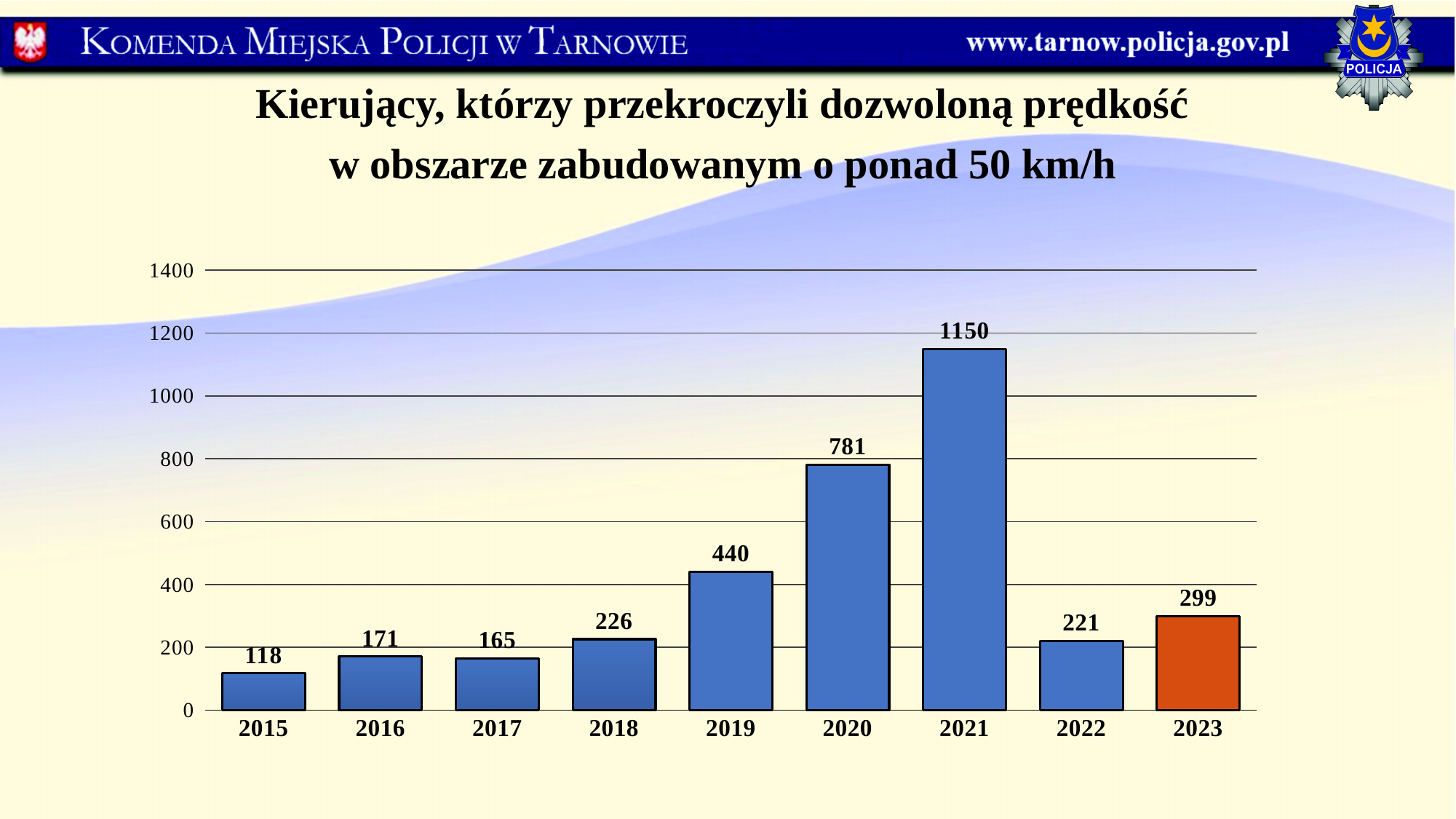
What kind of chart is shown on the slide? bar chart Which year has the highest value? 2021 Which is larger, the value for 2016 or the value for 2017? 2016 Is the value for 2019 greater or less than 400? greater What is the value for 2023? 299 How many years are shown on the x axis? 9 Which year has the lowest value? 2015 Which bar is shown in a different colour (orange) from the others? 2023 What is the value for 2021? 1150 What is the value for 2015? 118 What is the difference between the values for 2023 and 2022? 78 What is the difference between the values for 2021 and 2020? 369